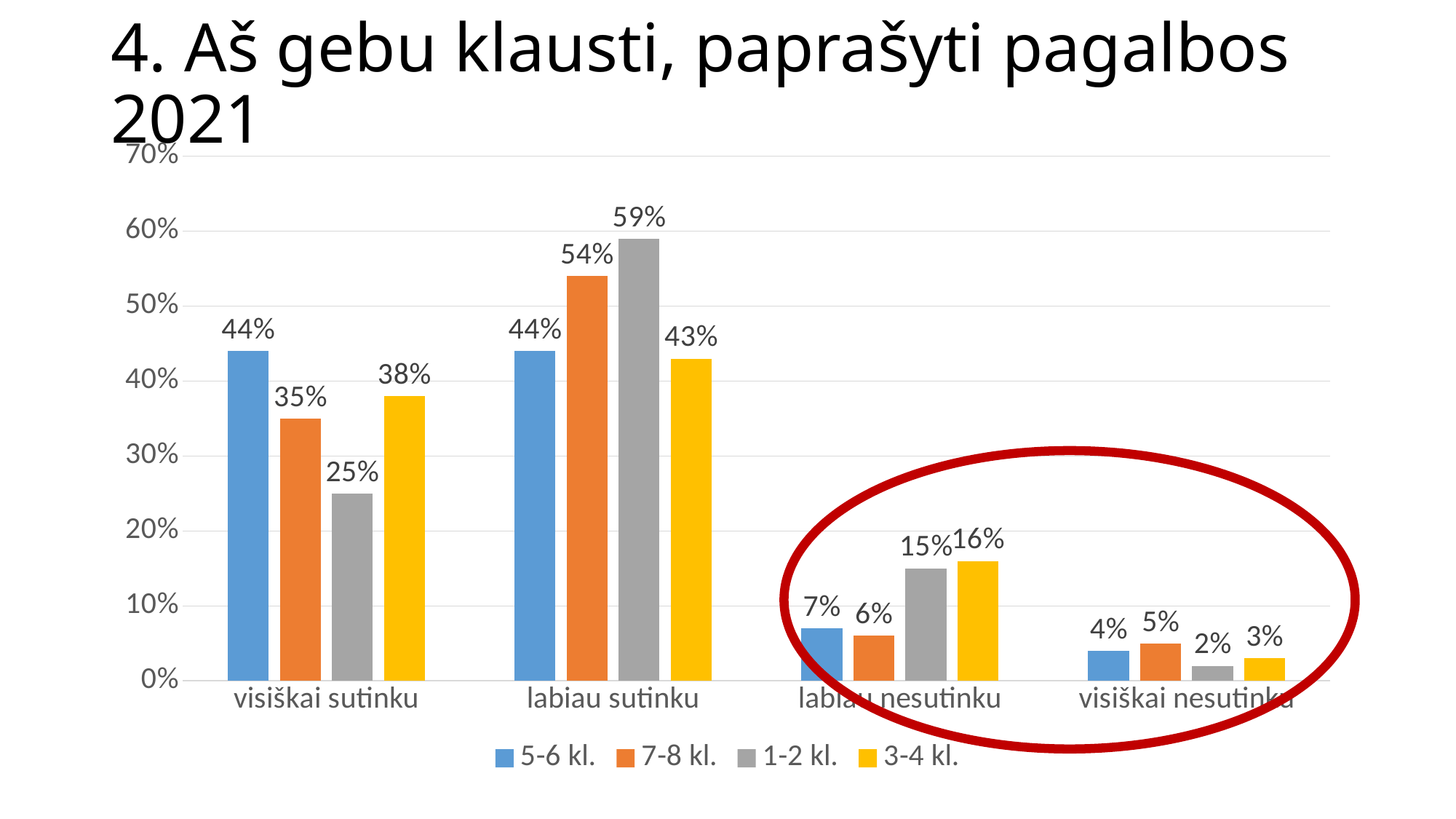
What is the value for 1-2 kl. in the "labiau sutinku" category? 59% How many series does the legend list? 4 What is the value for 3-4 kl. in the "visiškai sutinku" category? 38% Is the value for 7-8 kl. in the "labiau sutinku" category greater or less than 50%? greater Which two categories are circled in red on the chart? labiau nesutinku and visiškai nesutinku What is the difference between the 1-2 kl. and 5-6 kl. values in the "labiau sutinku" category? 15% In the "visiškai sutinku" category, which is larger: the value for 7-8 kl. or the value for 1-2 kl.? 7-8 kl. Which series has the highest value in the "visiškai sutinku" category? 5-6 kl. Which series has the lowest value in the "visiškai nesutinku" category? 1-2 kl. How many categories are shown on the x axis? 4 What is the value for 7-8 kl. in the "labiau nesutinku" category? 6% What kind of chart is shown on the slide? bar chart